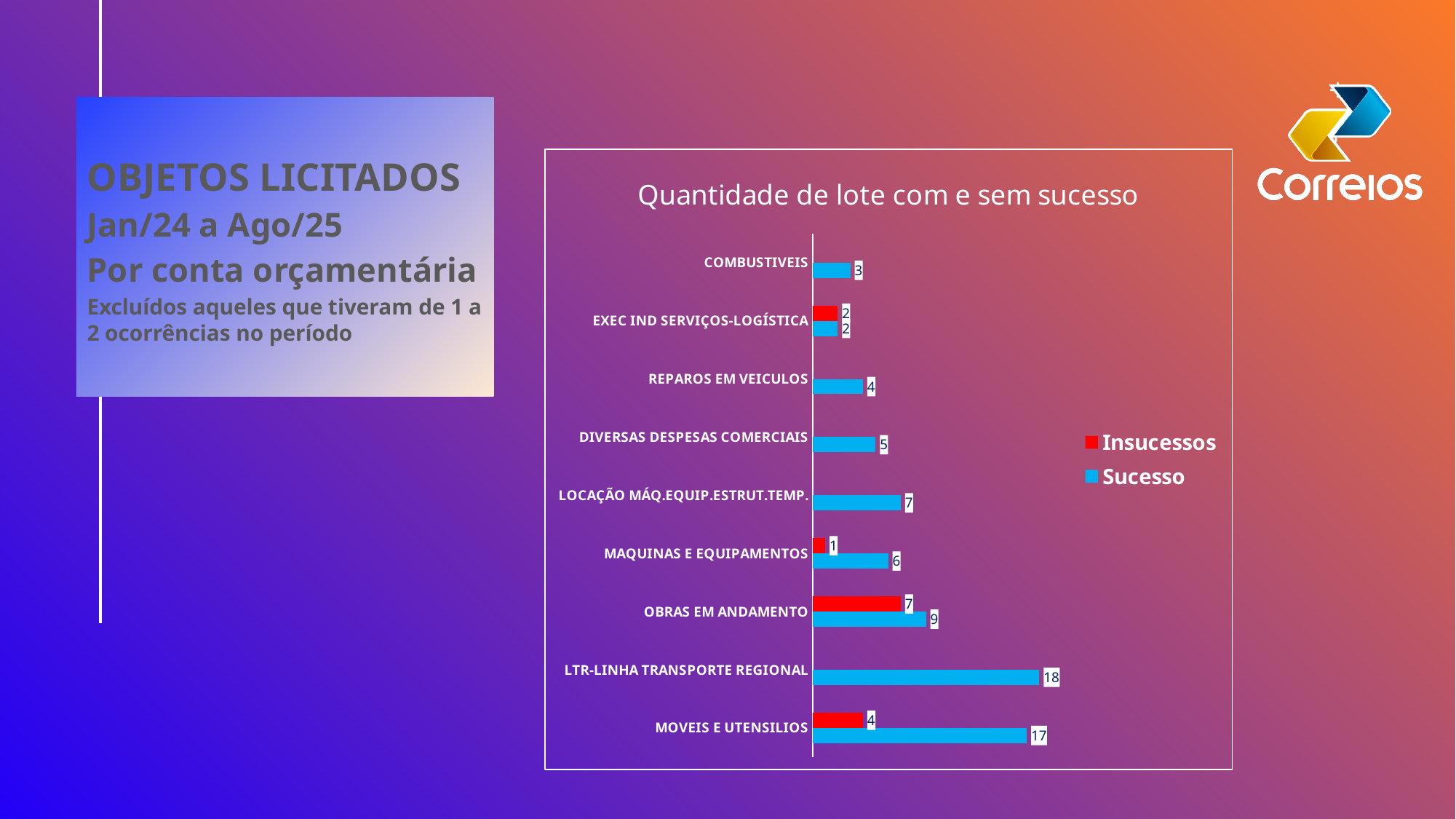
What kind of chart is shown on the slide? Bar chart Which category has the highest Sucesso value? LTR-LINHA TRANSPORTE REGIONAL How many categories are shown on the chart? 9 How many series does the legend list? 2 What is the Insucessos value for OBRAS EM ANDAMENTO? 7 What is the Sucesso value for LTR-LINHA TRANSPORTE REGIONAL? 18 What is the difference between the Sucesso and Insucessos values for MOVEIS E UTENSILIOS? 13 Which is larger for OBRAS EM ANDAMENTO, Sucesso or Insucessos? Sucesso What is the Insucessos value for MAQUINAS E EQUIPAMENTOS? 1 What is the title of the chart? Quantidade de lote com e sem sucesso Which category has the lowest Sucesso value? EXEC IND SERVIÇOS-LOGÍSTICA What is the Sucesso value for MOVEIS E UTENSILIOS? 17